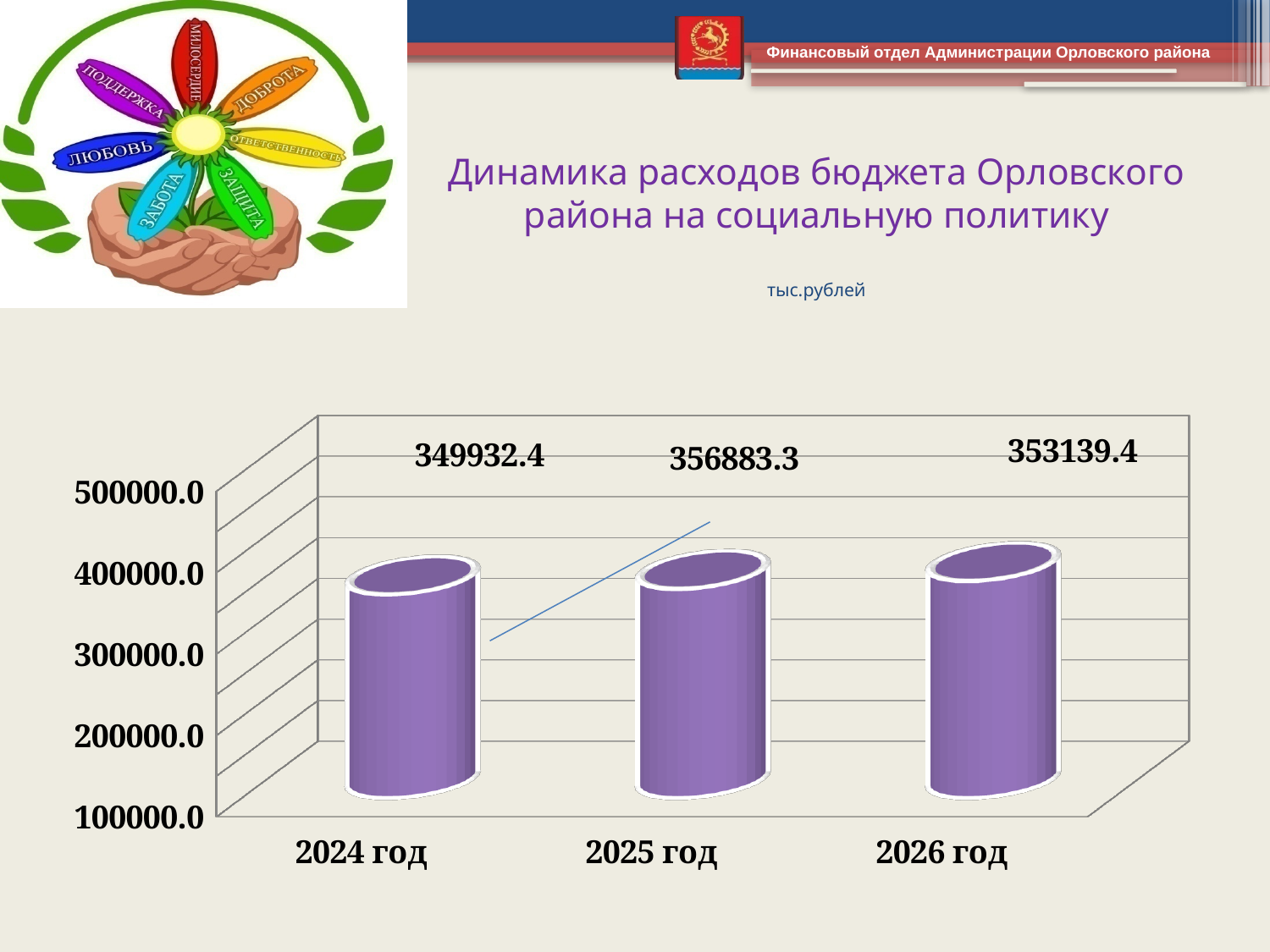
What is the value for 2026 год? 353139.4 Is the value for 2024 год greater or less than 300000.0? greater What kind of chart is shown on the slide? bar chart What is the value for 2024 год? 349932.4 Which is larger, the value for 2026 год or the value for 2024 год? 2026 год Which year has the lowest value? 2024 год How many years are shown on the chart? 3 What is the difference between the values for 2025 год and 2026 год? 3743.9 What is the difference between the values for 2025 год and 2024 год? 6950.9 In what units are the values on the chart given? тыс.рублей What is the value for 2025 год? 356883.3